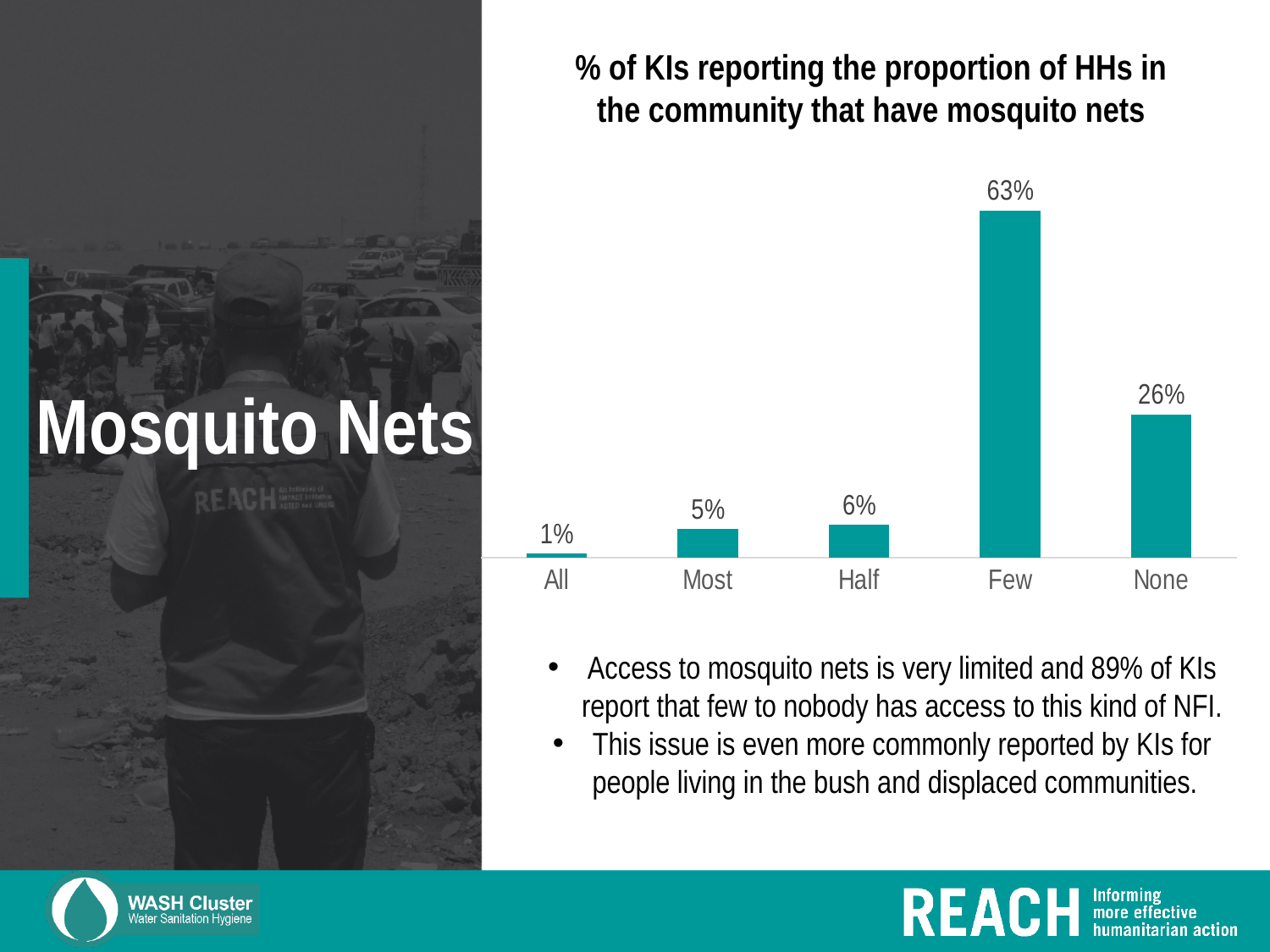
What percentage of KIs reported that most households have mosquito nets? 5% Which has a higher percentage, Half or Most? Half What percentage of KIs reported that all households have mosquito nets? 1% How many categories are shown on the x axis of the chart? 5 Which category has the lowest percentage of KIs? All Which category has the highest percentage of KIs? Few What is the combined percentage for the Few and None categories? 89% What kind of chart is shown on the slide? Bar chart What percentage of KIs reported that few households in the community have mosquito nets? 63% What is the title of the chart? % of KIs reporting the proportion of HHs in the community that have mosquito nets What percentage of KIs reported that no households have mosquito nets? 26% What is the difference between the percentage for Few and the percentage for None? 37%